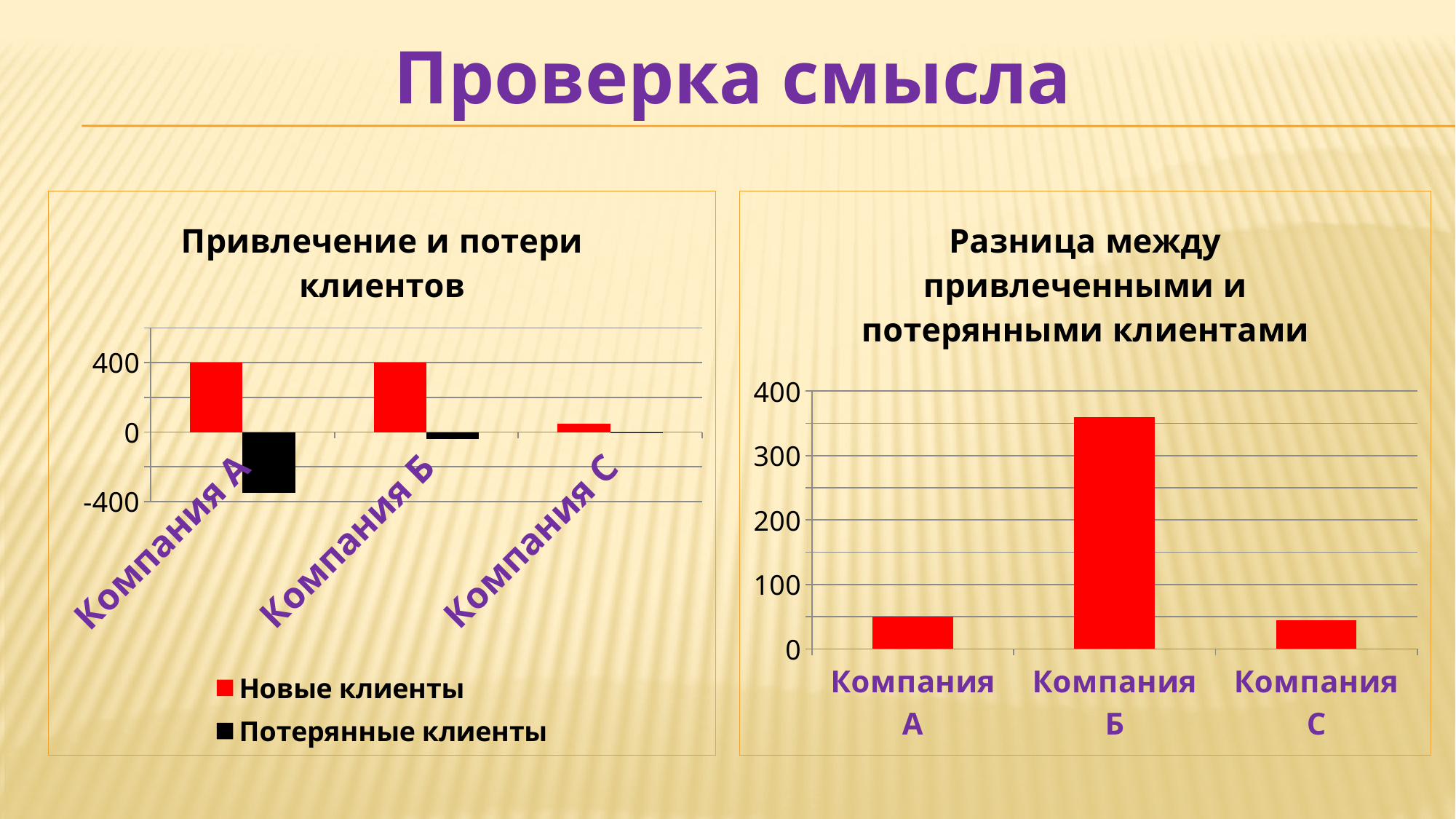
In the left chart, which is larger for Новые клиенты: Компания Б or Компания С? Компания Б In the right chart, is the value for Компания Б greater or less than 300? greater In the right chart, is the value for Компания С greater or less than 100? less In the right chart, is the value for Компания А greater or less than 100? less In the right chart, which company has the highest value? Компания Б In the right chart, which is larger: the value for Компания Б or the value for Компания С? Компания Б In the left chart, which company has the lowest (most negative) value for Потерянные клиенты? Компания А How many series does the legend of the left chart list? 2 In the left chart, what colour represents the series 'Потерянные клиенты'? black How many categories are shown on the right chart? 3 What kind of chart is the right chart titled 'Разница между привлеченными и потерянными клиентами'? bar chart What kind of chart is the left chart titled 'Привлечение и потери клиентов'? bar chart